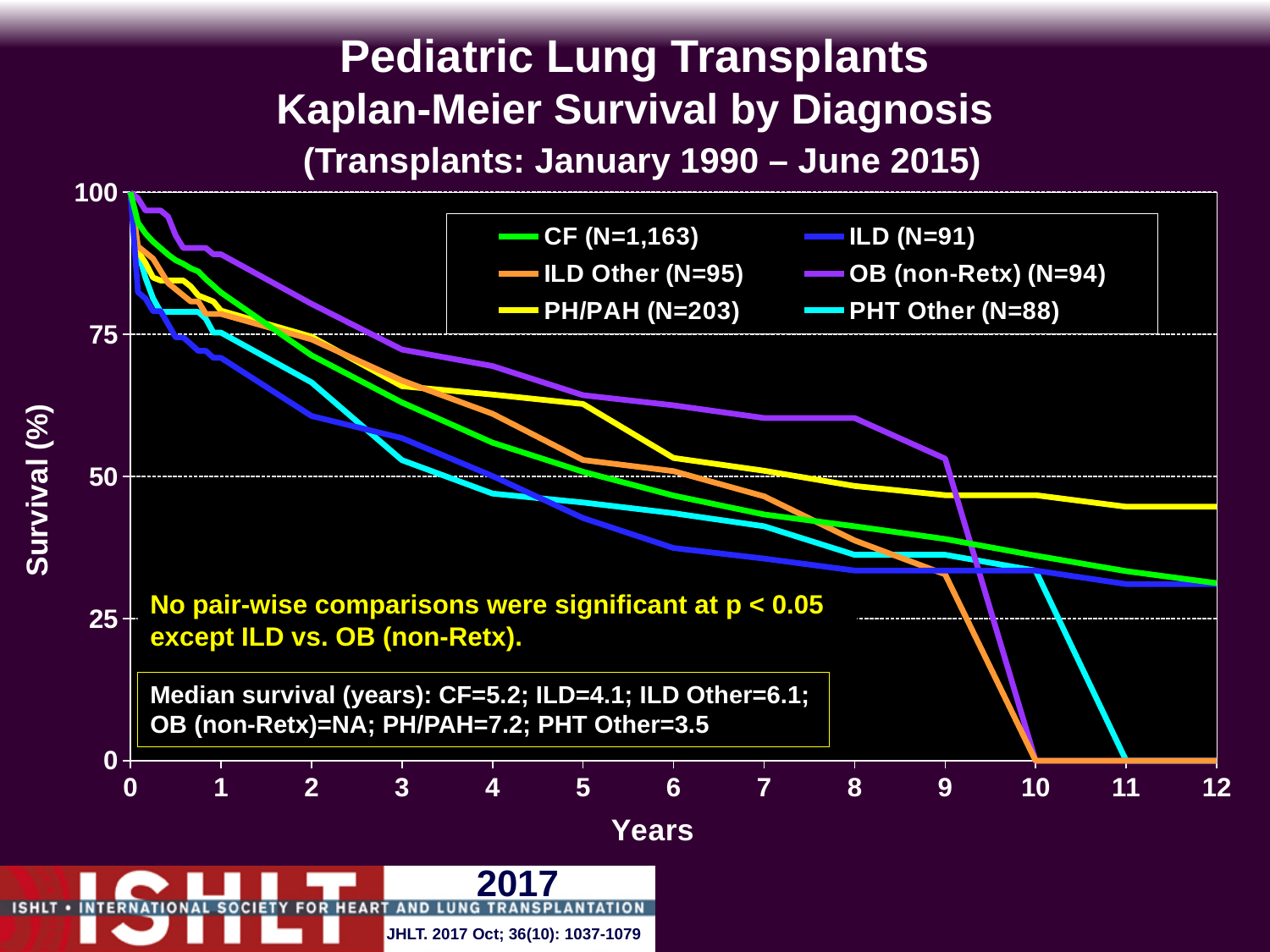
What type of chart is shown on the slide? Line chart Is the survival for PH/PAH at 12 years greater or less than 25? greater According to the slide, what is the median survival in years for the PH/PAH group? 7.2 Is the survival for CF at 12 years greater or less than 50? less Do the survival curves rise or fall as years increase? Fall What is the number of transplants (N) for the CF group shown in the legend? 1,163 Which diagnosis group has the largest number of transplants (N) in the legend? CF At 8 years, which series has higher survival: PH/PAH or ILD? PH/PAH How many diagnosis groups (series) does the legend list? 6 Which diagnosis group has the shortest median survival listed on the slide? PHT Other Which series has the highest survival at 12 years? PH/PAH What is the label of the y-axis? Survival (%)